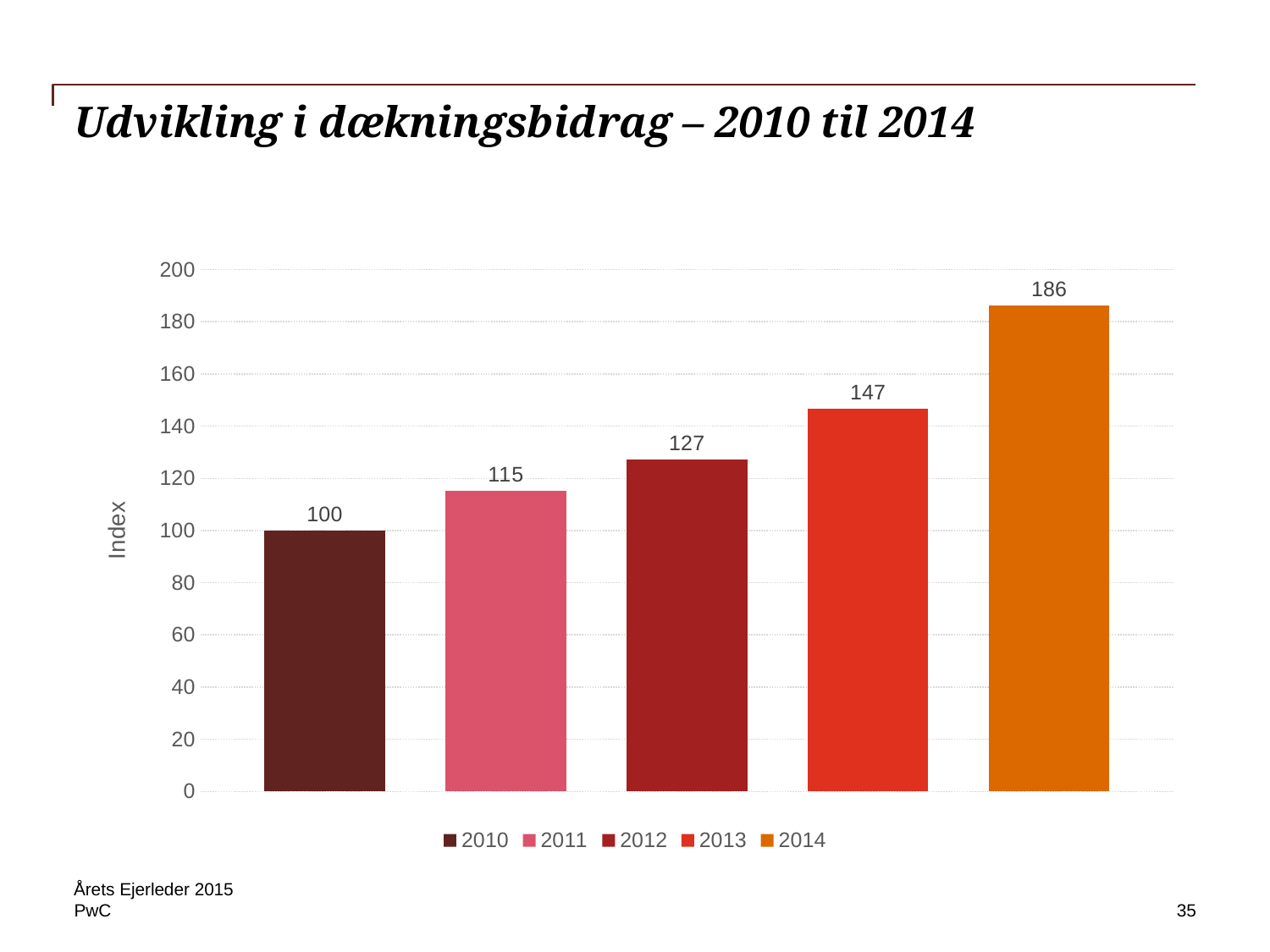
How many entries does the legend list? 5 Do the index values rise or fall from 2010 to 2014? rise What is the difference between the index values for 2013 and 2012? 20 Which year has the lowest index value? 2010 What is the index value for 2012? 127 How many years are shown in the chart? 5 Which is larger, the index value for 2011 or for 2013? 2013 Is the index value for 2013 greater or less than 140? greater Which year has the highest index value? 2014 What kind of chart is shown on the slide? bar chart What is the difference between the index values for 2014 and 2010? 86 What is the index value for 2014? 186